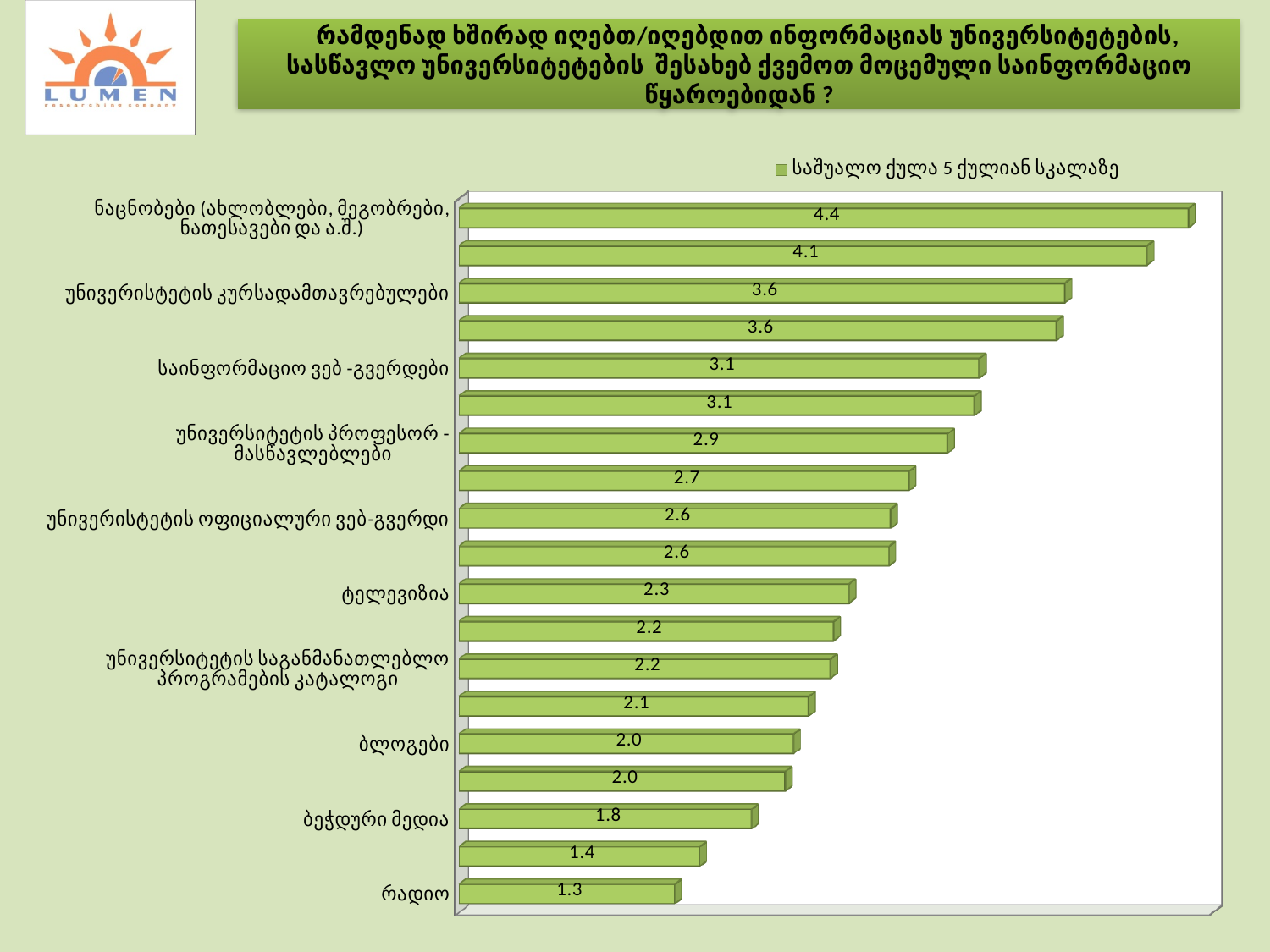
What is the average score for ბეჭდური მედია? 1.8 What is the average score for ნაცნობები (ახლობლები, მეგობრები, ნათესავები და ა.შ.)? 4.4 Which has a higher average score, ტელევიზია or ბლოგები? ტელევიზია What is the average score for რადიო? 1.3 What is the legend entry of the chart? საშუალო ქულა 5 ქულიან სკალაზე How many series does the legend list? 1 What type of chart is shown on the slide? bar chart What is the difference between the average scores for ნაცნობები and რადიო? 3.1 What is the average score for უნივერსიტეტის კურსადამთავრებულები? 3.6 Which labeled information source has the lowest average score? რადიო What is the average score for ტელევიზია? 2.3 Which labeled information source has the highest average score? ნაცნობები (ახლობლები, მეგობრები, ნათესავები და ა.შ.)